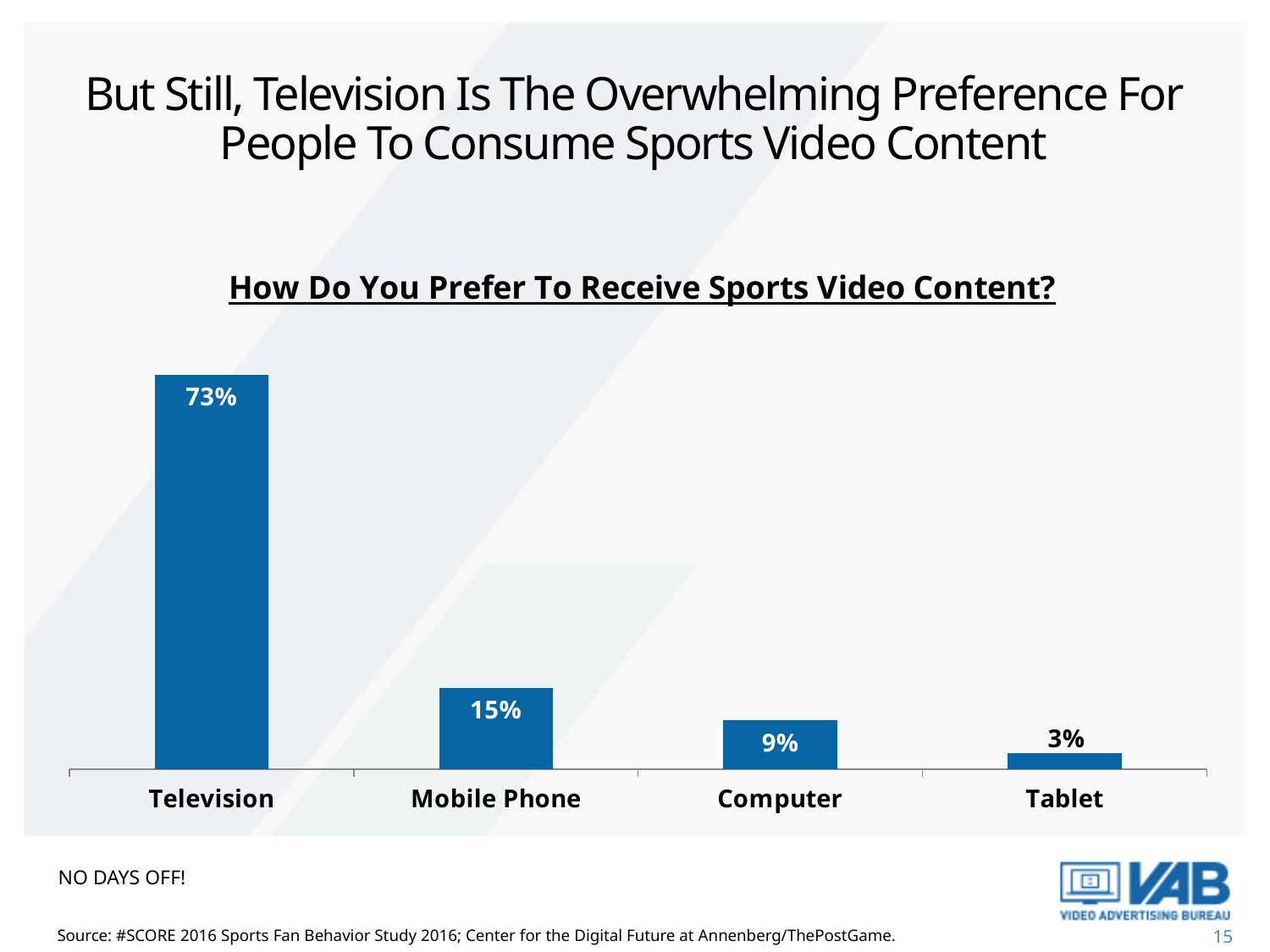
What kind of chart is shown on the slide? Bar chart What is the value shown for Computer? 9% Which category has the highest value? Television Which is larger, the value for Mobile Phone or the value for Computer? Mobile Phone What is the difference between the Television and Mobile Phone values? 58% What is the value shown for Tablet? 3% What is the value shown for Mobile Phone? 15% Which category has the lowest value? Tablet What is the difference between the Computer and Tablet values? 6% How many categories are shown on the x axis? 4 What is the title of the chart? How Do You Prefer To Receive Sports Video Content? What percentage of people prefer to receive sports video content on Television? 73%